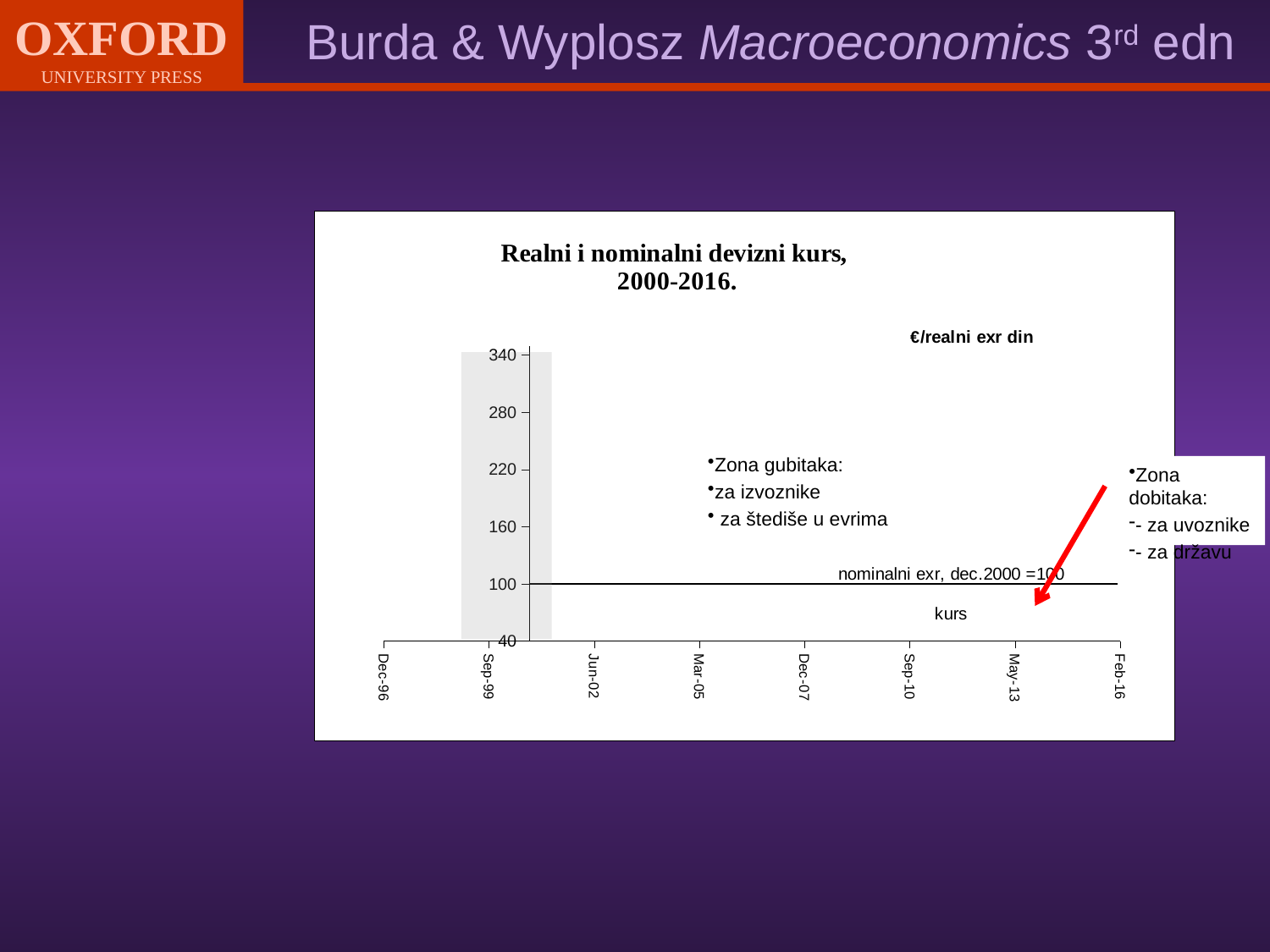
How many date labels are shown along the x axis? 8 What is the highest value shown on the y axis? 340 What is the lowest value shown on the y axis? 40 What is the last date label on the x axis? Feb-16 At what value is the horizontal line labelled "nominalni exr, dec.2000 =100 kurs" drawn? 100 What label appears in the upper right of the plot area describing the series unit? €/realni exr din What is the interval between consecutive y-axis tick labels? 60 What is the first date label on the x axis? Dec-96 Does the horizontal line for the nominal exchange rate rise, fall, or stay flat across the x axis? stay flat Which x-axis label comes immediately after Dec-07? Sep-10 What is the title of the chart? Realni i nominalni devizni kurs, 2000-2016.